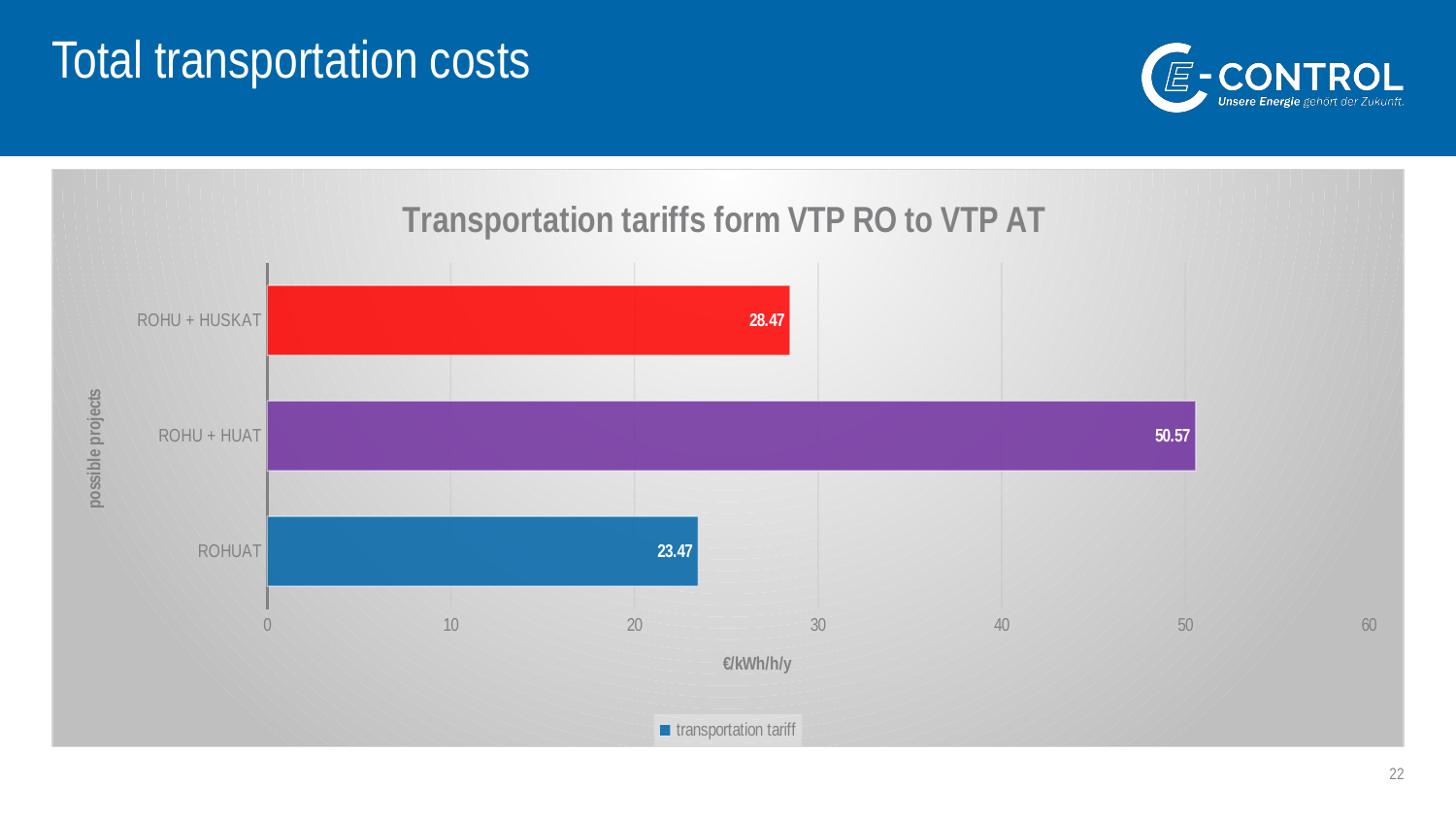
What is the difference between the transportation tariffs of ROHU + HUSKAT and ROHUAT? 5.00 How many projects are shown in the chart? 3 Which project has the highest transportation tariff? ROHU + HUAT Is the value for ROHU + HUAT greater or less than 40? greater What is the transportation tariff for ROHU + HUAT? 50.57 What type of chart is shown on the slide? Bar chart What is the title of the chart? Transportation tariffs form VTP RO to VTP AT What is the transportation tariff for ROHU + HUSKAT? 28.47 What is the transportation tariff for ROHUAT? 23.47 Which has a larger transportation tariff, ROHU + HUSKAT or ROHU + HUAT? ROHU + HUAT Which project has the lowest transportation tariff? ROHUAT What is the difference between the transportation tariffs of ROHU + HUAT and ROHUAT? 27.10